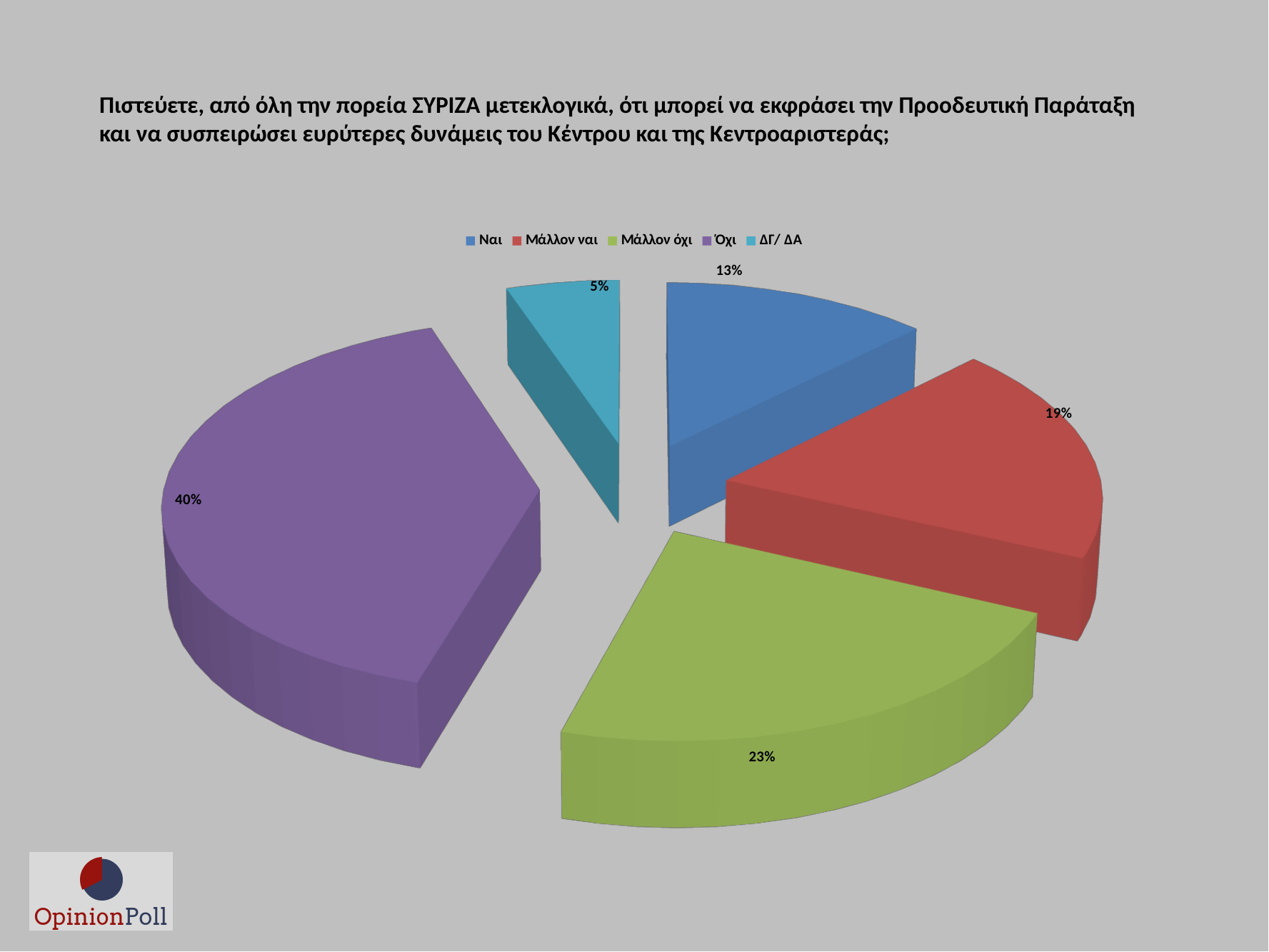
What percentage is shown for the 'Μάλλον όχι' slice? 23% How many categories does the legend list? 5 What kind of chart is shown on the slide? Pie chart Which category has the smallest share of the pie? ΔΓ/ ΔΑ Which is larger, the share for 'Μάλλον ναι' or the share for 'Μάλλον όχι'? Μάλλον όχι What colour is the 'Όχι' slice? Purple What is the difference in percentage points between 'Όχι' and 'Ναι'? 27 What percentage is shown for the 'Όχι' slice? 40% What percentage is shown for the 'ΔΓ/ ΔΑ' slice? 5% What percentage is shown for the 'Μάλλον ναι' slice? 19% Which category has the largest share of the pie? Όχι What percentage is shown for the 'Ναι' slice? 13%